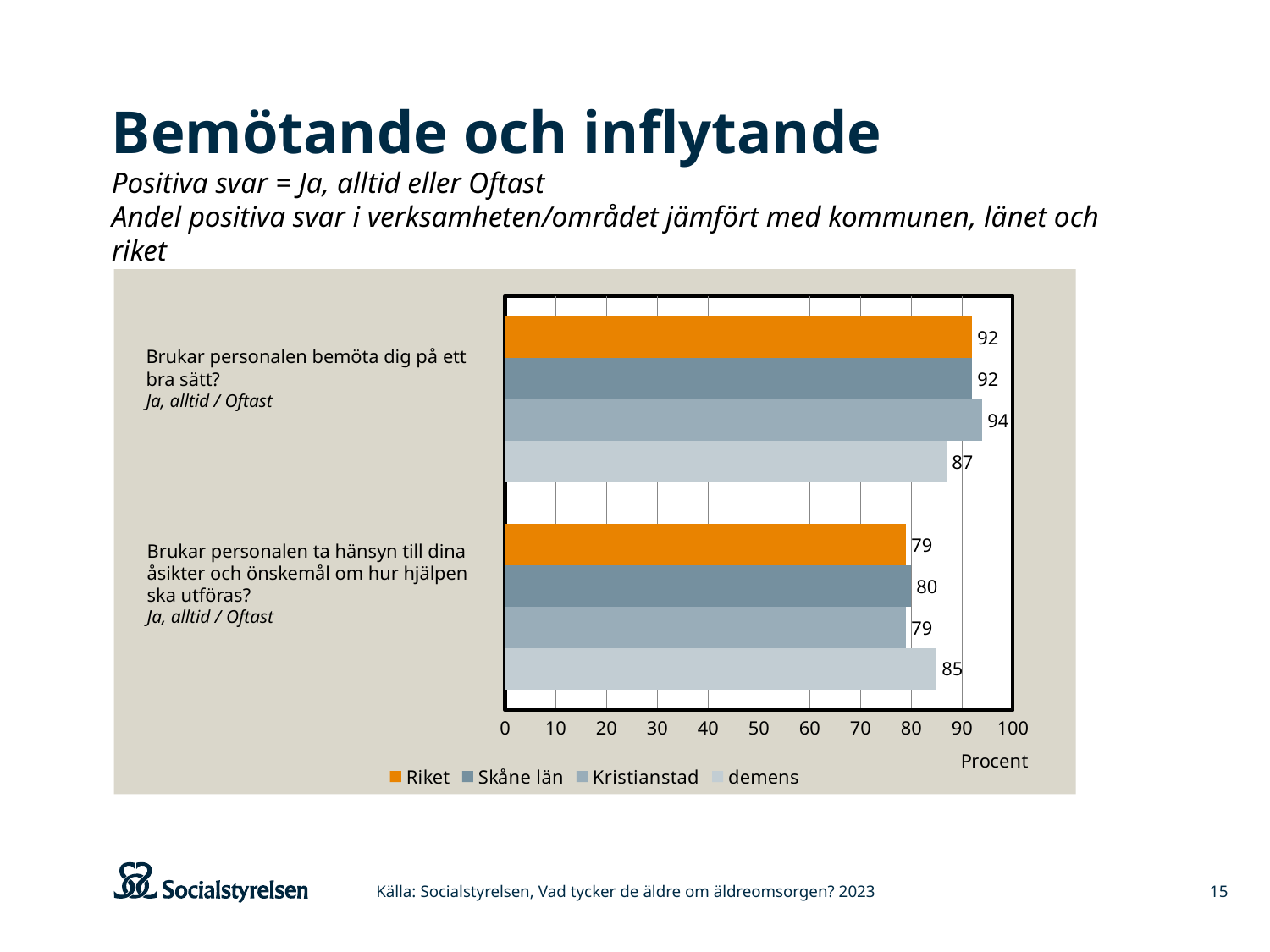
What is the value for Riket for the question "Brukar personalen ta hänsyn till dina åsikter och önskemål om hur hjälpen ska utföras?"? 79 What label is shown on the horizontal axis of the chart? Procent What is the value for demens for the question "Brukar personalen ta hänsyn till dina åsikter och önskemål om hur hjälpen ska utföras?"? 85 What kind of chart is shown on the slide? bar chart How many series does the legend list? 4 What is the value for demens for the question "Brukar personalen bemöta dig på ett bra sätt?"? 87 What is the value for Kristianstad for the question "Brukar personalen bemöta dig på ett bra sätt?"? 94 For the question "Brukar personalen ta hänsyn till dina åsikter och önskemål om hur hjälpen ska utföras?", which is larger: the value for demens or the value for Skåne län? demens What is the difference between the Kristianstad value and the demens value for the question "Brukar personalen bemöta dig på ett bra sätt?"? 7 Which series has the highest value for the question "Brukar personalen bemöta dig på ett bra sätt?"? Kristianstad Which series has the lowest value for the question "Brukar personalen ta hänsyn till dina åsikter och önskemål om hur hjälpen ska utföras?"? Riket and Kristianstad (both 79) How many questions (categories) are shown on the chart? 2